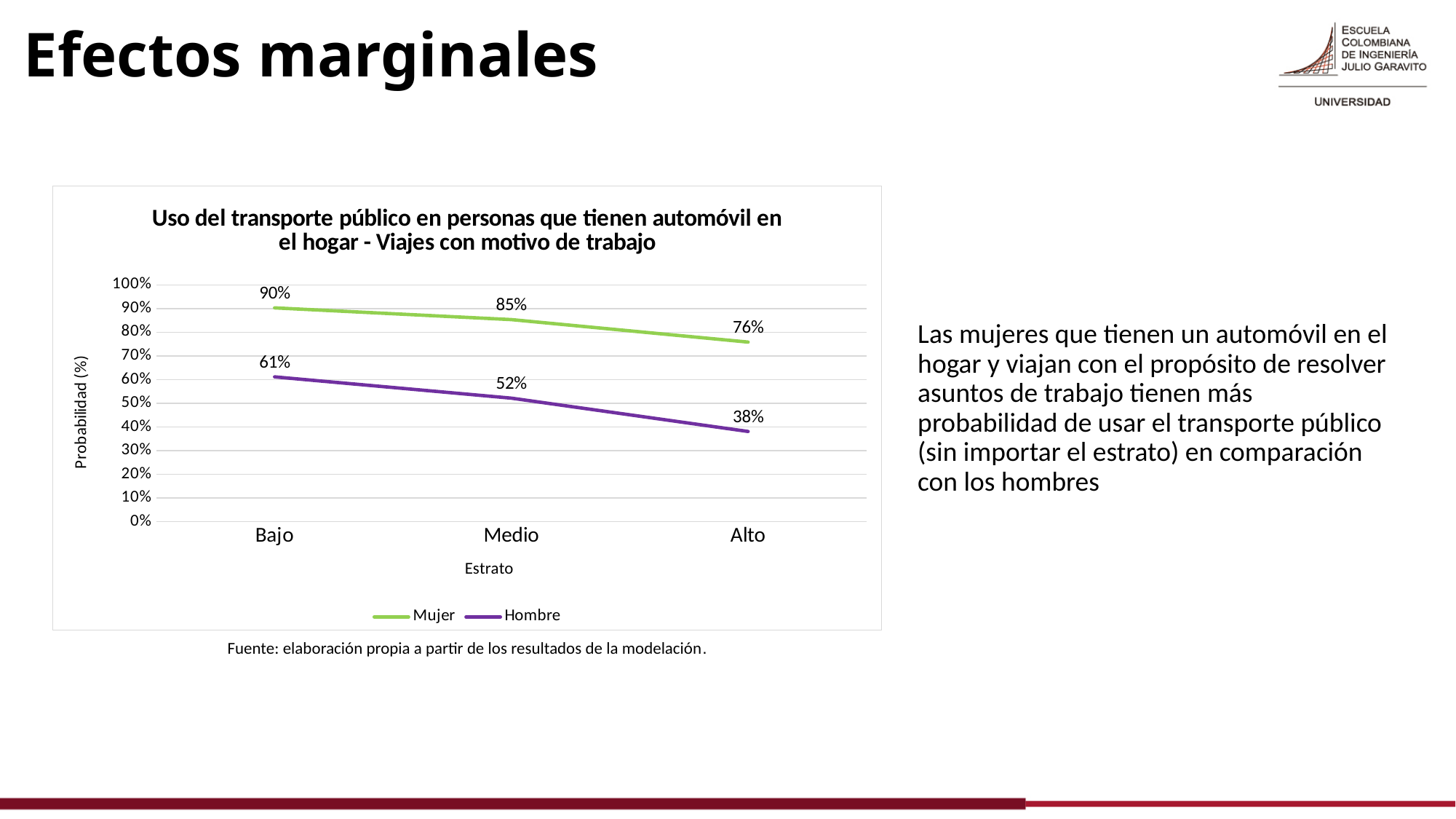
What is the value for Mujer at the Bajo estrato? 90% Which estrato has the lowest value for the Mujer series? Alto What is the value for Hombre at the Medio estrato? 52% How many estrato categories are shown on the x axis? 3 Which series has the larger value at the Alto estrato, Mujer or Hombre? Mujer What kind of chart is shown on the slide? Line chart Do the values for the Hombre series rise or fall from Bajo to Alto? Fall What is the value for Mujer at the Alto estrato? 76% Which estrato has the highest value for the Hombre series? Bajo How many series does the legend list? 2 What is the value for Hombre at the Alto estrato? 38% What is the difference between the Mujer and Hombre values at the Medio estrato? 33%